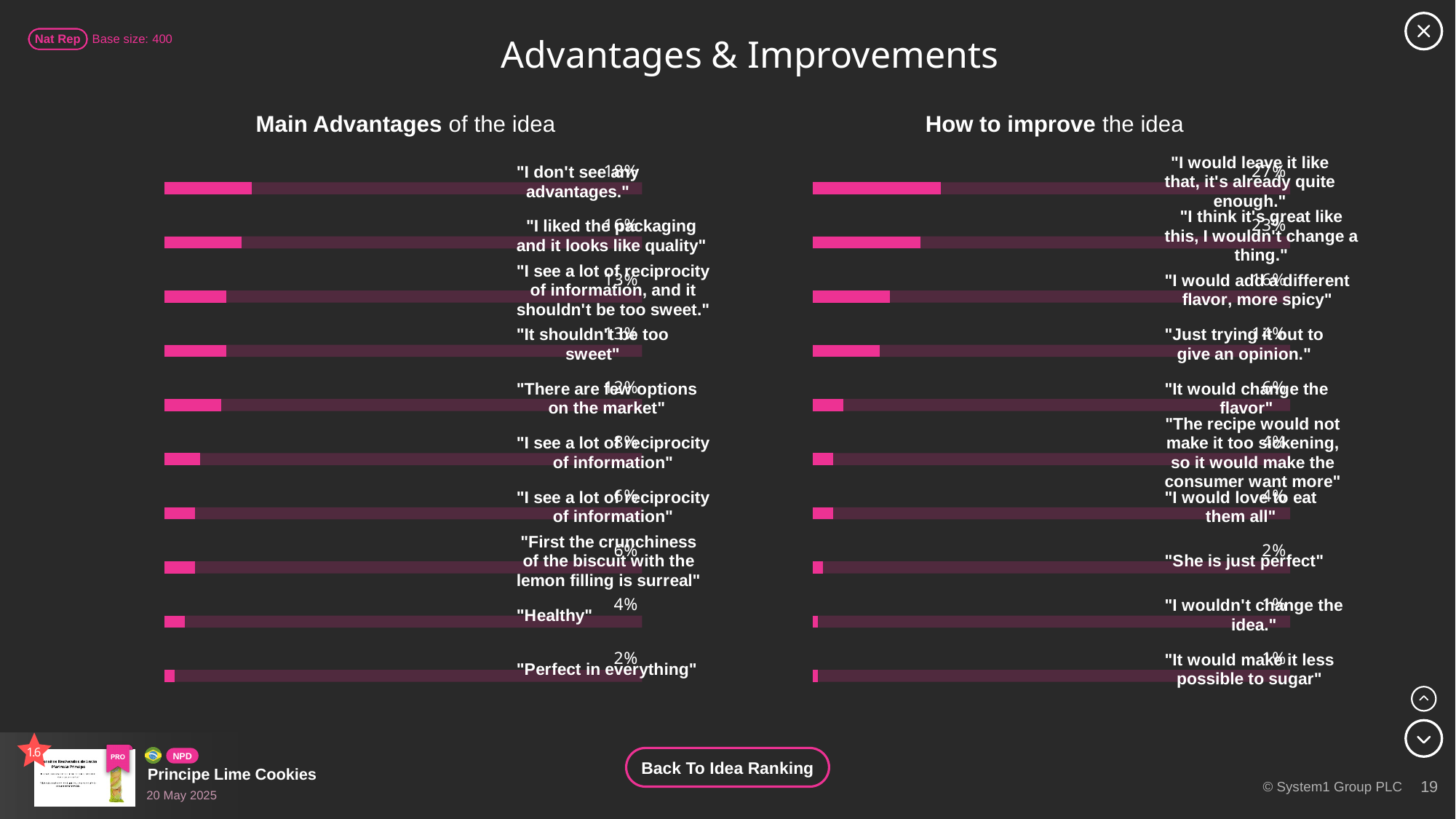
How many categories are shown in the 'How to improve the idea' chart? 10 What kind of chart is used for 'Main Advantages of the idea'? Bar chart In the 'How to improve the idea' chart, what is the value for 'I would leave it like that, it's already quite enough.'? 27% In the 'Main Advantages of the idea' chart, which category has the lowest value? "Perfect in everything" In the 'Main Advantages of the idea' chart, what is the value for 'Healthy'? 4% In the 'How to improve the idea' chart, what is the value for 'She is just perfect'? 2% In the 'Main Advantages of the idea' chart, which category has the highest value? "I don't see any advantages." In the 'Main Advantages of the idea' chart, what is the value for 'Perfect in everything'? 2% In the 'How to improve the idea' chart, which is larger: 'I would leave it like that, it's already quite enough.' or 'She is just perfect'? "I would leave it like that, it's already quite enough." What base size is shown on the slide? 400 In the 'How to improve the idea' chart, which category has the highest value? "I would leave it like that, it's already quite enough." In the 'Main Advantages of the idea' chart, what is the difference between 'Healthy' and 'Perfect in everything'? 2 percentage points